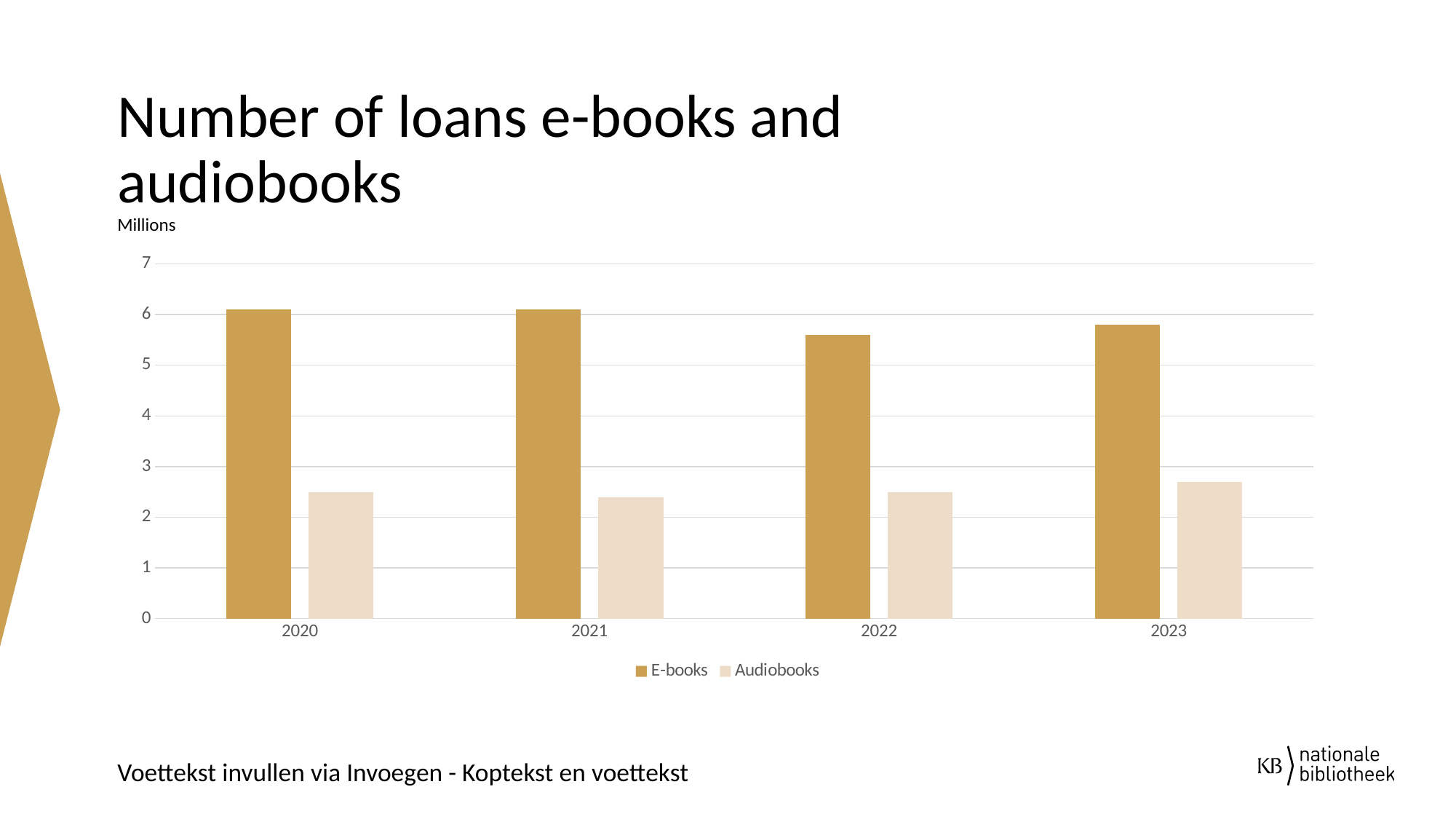
Is the value for E-books in 2022 greater or less than 6? less Is the value for Audiobooks in 2023 greater or less than 3? less Which year has the highest value for Audiobooks? 2023 What unit is shown above the vertical axis? Millions Which year has the lowest value for E-books? 2022 How many years are shown on the x axis? 4 How many series does the legend list? 2 In 2023, which is larger: E-books or Audiobooks? E-books Which is larger: E-books in 2022 or E-books in 2023? E-books in 2023 Is the value for Audiobooks in 2021 greater or less than 2? greater What kind of chart is shown on the slide? bar chart